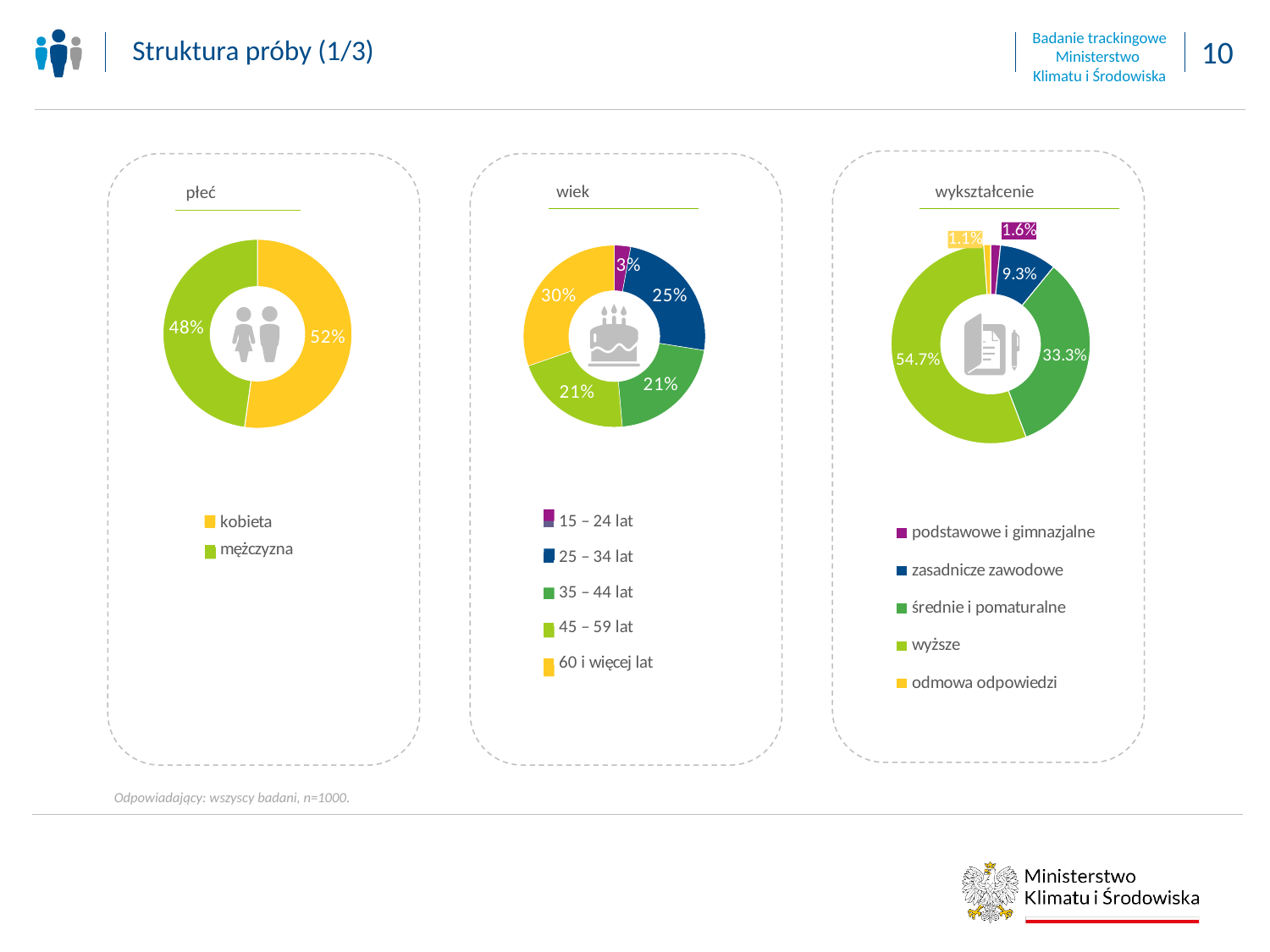
In the 'wiek' chart, how many age groups does the legend list? 5 What type of chart is used for 'płeć'? Donut (pie) chart In the 'wiek' chart, what share is the 25 – 34 lat group? 25% In the 'wiek' chart, which age group has the smallest share? 15 – 24 lat In the 'wykształcenie' chart, what share is zasadnicze zawodowe? 9.3% In the 'wykształcenie' chart, which is larger: podstawowe i gimnazjalne or odmowa odpowiedzi? podstawowe i gimnazjalne In the 'wiek' chart, what share is the 60 i więcej lat group? 30% In the 'wykształcenie' chart, what is the difference between wyższe and średnie i pomaturalne? 21.4 percentage points In the 'płeć' chart, what share is kobieta? 52% In the 'wykształcenie' chart, which category has the largest share? wyższe In the 'wykształcenie' chart, what share is wyższe? 54.7% In the 'płeć' chart, what share is mężczyzna? 48%